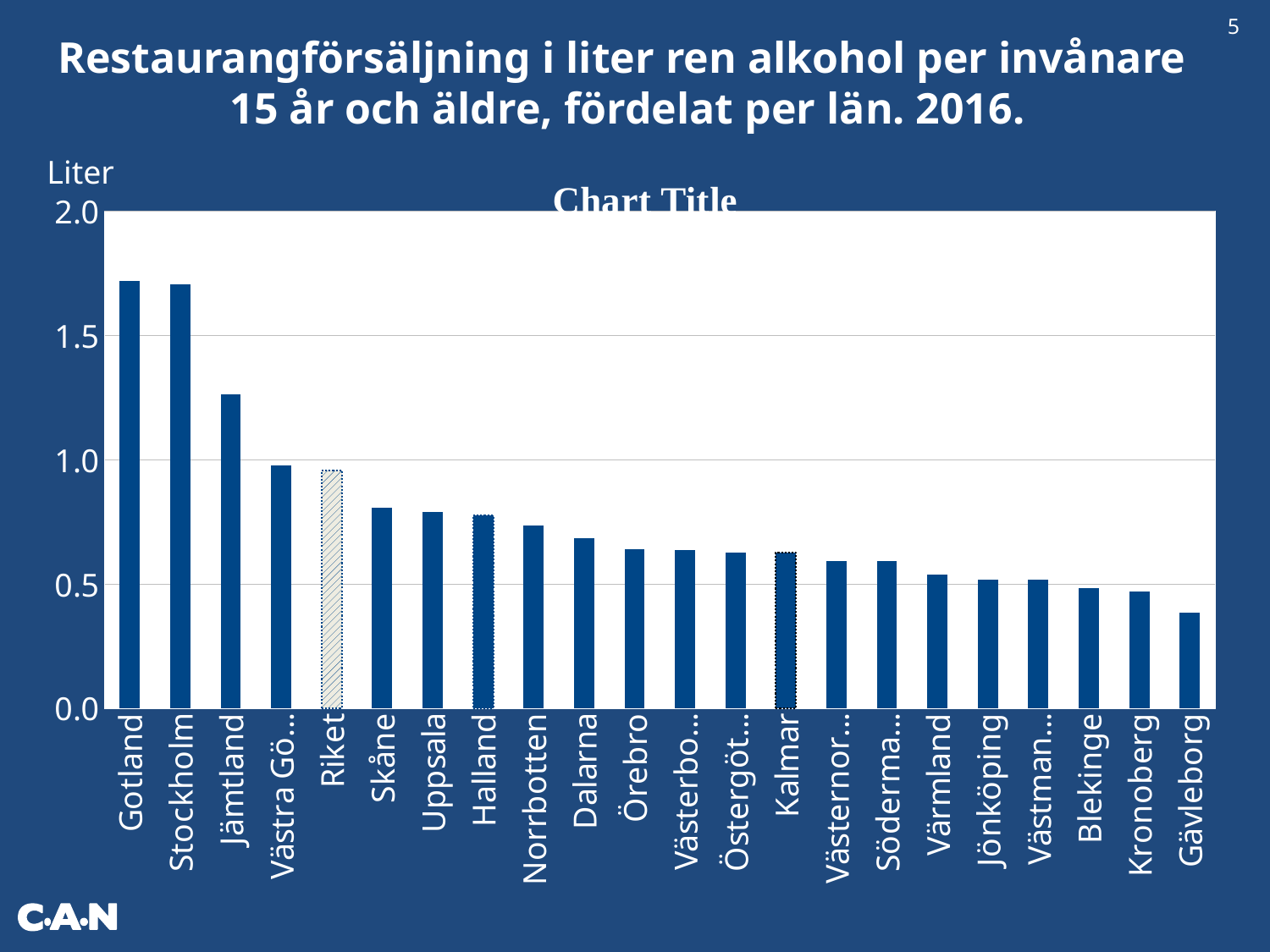
What unit label is shown above the vertical axis of the chart? Liter Which is larger, the value for Jämtland or the value for Skåne? Jämtland Do the values generally rise or fall moving from left to right along the x axis? fall Is the value for Jämtland greater or less than 1.0? greater Which category has the lowest value in the chart? Gävleborg Is the value for Norrbotten greater or less than 0.5? greater Is the value for Gotland greater or less than 1.5? greater Which is larger, the value for Kronoberg or the value for Uppsala? Uppsala How many bars (categories) are plotted in the chart? 22 What kind of chart is shown on the slide? bar chart